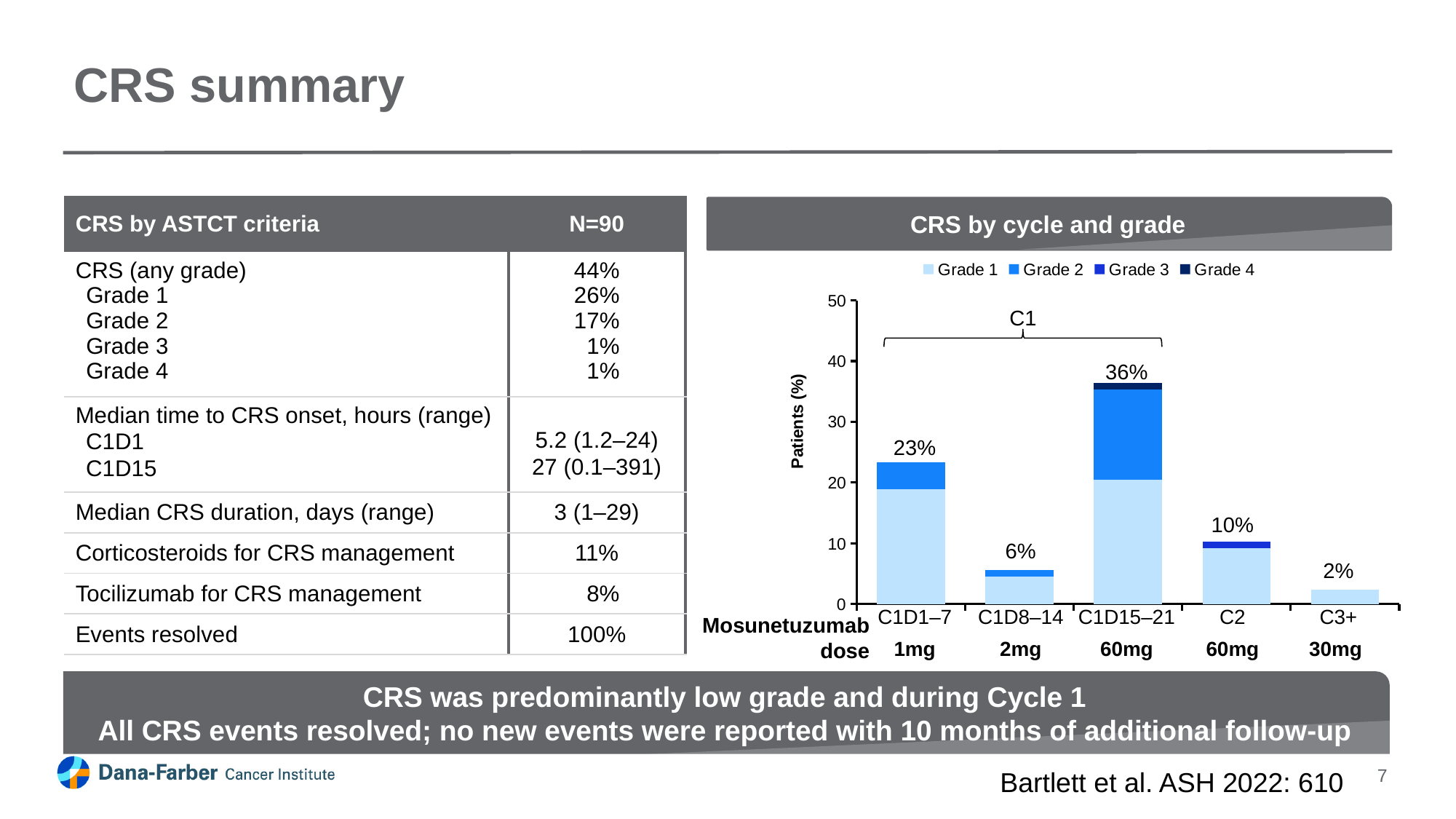
What is the total CRS rate shown above the C1D15–21 bar? 36% What type of chart is used to show CRS by cycle and grade? Stacked bar chart How many cycle periods are shown on the x axis of the chart? 5 Which cycle period has the highest total CRS rate? C1D15–21 How many grade series does the chart legend list? 4 What is the total value labelled for the C1D1–7 bar? 23% Is the total value for C2 greater or less than 20? less What is the label of the y axis of the chart? Patients (%) Which has a higher total CRS rate, C1D8–14 or C2? C2 Which cycle period has the lowest total CRS rate? C3+ What is the difference between the total CRS rate at C1D15–21 and at C1D1–7? 13% What is the value labelled for the C3+ bar? 2%